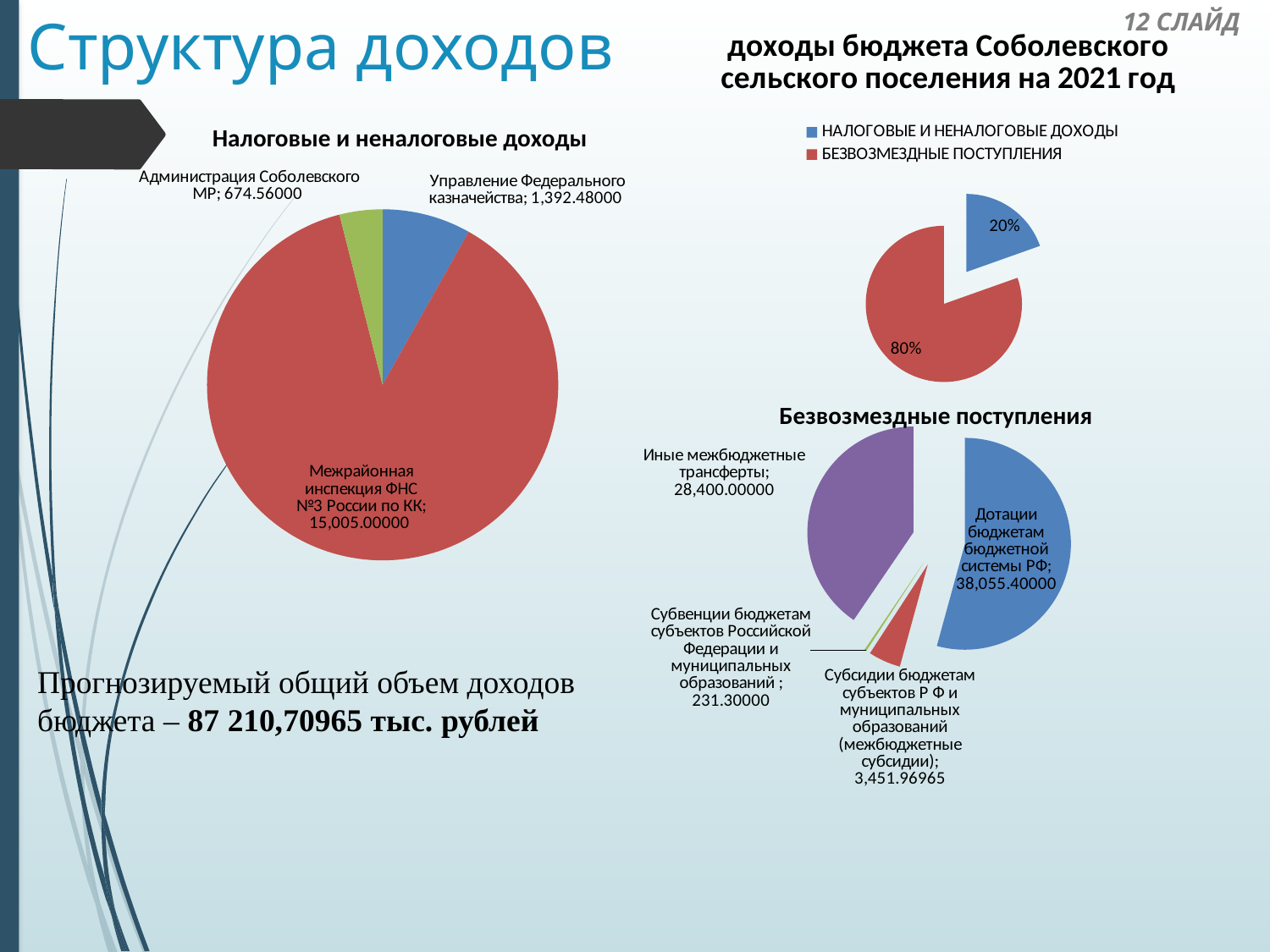
In the chart titled 'Безвозмездные поступления', which is larger: Субсидии бюджетам субъектов РФ и муниципальных образований (межбюджетные субсидии) or Субвенции бюджетам субъектов Российской Федерации и муниципальных образований? Субсидии бюджетам субъектов РФ и муниципальных образований (межбюджетные субсидии) In the chart titled 'Налоговые и неналоговые доходы', what is the difference between the values for Управление Федерального казначейства and Администрация Соболевского МР? 717.92000 In the chart titled 'Налоговые и неналоговые доходы', what is the value for Управление Федерального казначейства? 1,392.48000 In the chart titled 'Налоговые и неналоговые доходы', which category has the largest slice? Межрайонная инспекция ФНС №3 России по КК What kind of chart is the chart titled 'доходы бюджета Соболевского сельского поселения на 2021 год'? pie chart In the chart titled 'Безвозмездные поступления', what is the difference between the values for Дотации бюджетам бюджетной системы РФ and Иные межбюджетные трансферты? 9,655.40000 In the chart titled 'Налоговые и неналоговые доходы', which category has the smallest slice? Администрация Соболевского МР In the chart titled 'Налоговые и неналоговые доходы', how many slices does the pie have? 3 In the chart titled 'доходы бюджета Соболевского сельского поселения на 2021 год', how many entries does the legend list? 2 In the chart titled 'доходы бюджета Соболевского сельского поселения на 2021 год', what share of the pie is БЕЗВОЗМЕЗДНЫЕ ПОСТУПЛЕНИЯ? 80% In the chart titled 'Безвозмездные поступления', what is the value for Иные межбюджетные трансферты? 28,400.00000 In the chart titled 'Безвозмездные поступления', which category has the largest value? Дотации бюджетам бюджетной системы РФ